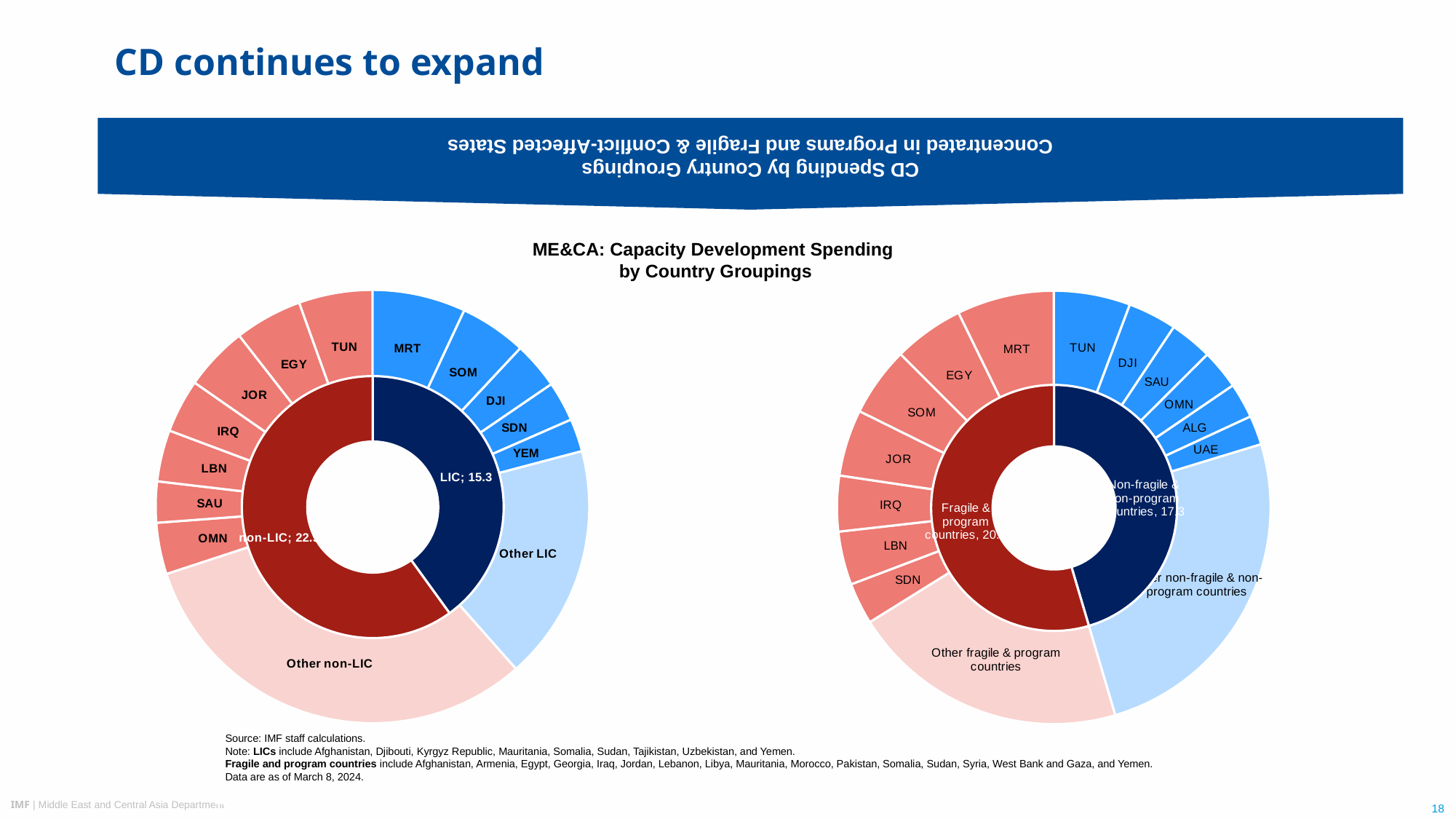
In the left chart, which inner-ring segment is larger, LIC or non-LIC? non-LIC In the right chart, how many segments make up the outer ring? 15 What is the title of the chart on the slide? ME&CA: Capacity Development Spending by Country Groupings What kind of chart is used on this slide? Donut (pie) chart In the left chart, which is larger among the LIC outer segments, MRT or YEM? MRT In the left chart, how many segments make up the outer ring? 14 In the left chart, which individually labelled LIC country has the smallest outer segment? YEM In the right chart, which outer-ring segment is the largest? Other non-fragile & non-program countries In the left chart, what colour is the LIC segment of the inner ring? Dark blue In the left chart, which outer-ring segment is the largest? Other non-LIC In the left chart, what value is shown for the LIC segment of the inner ring? 15.3 In the right chart, which inner-ring segment is larger, Fragile & program countries or Non-fragile & non-program countries? Fragile & program countries